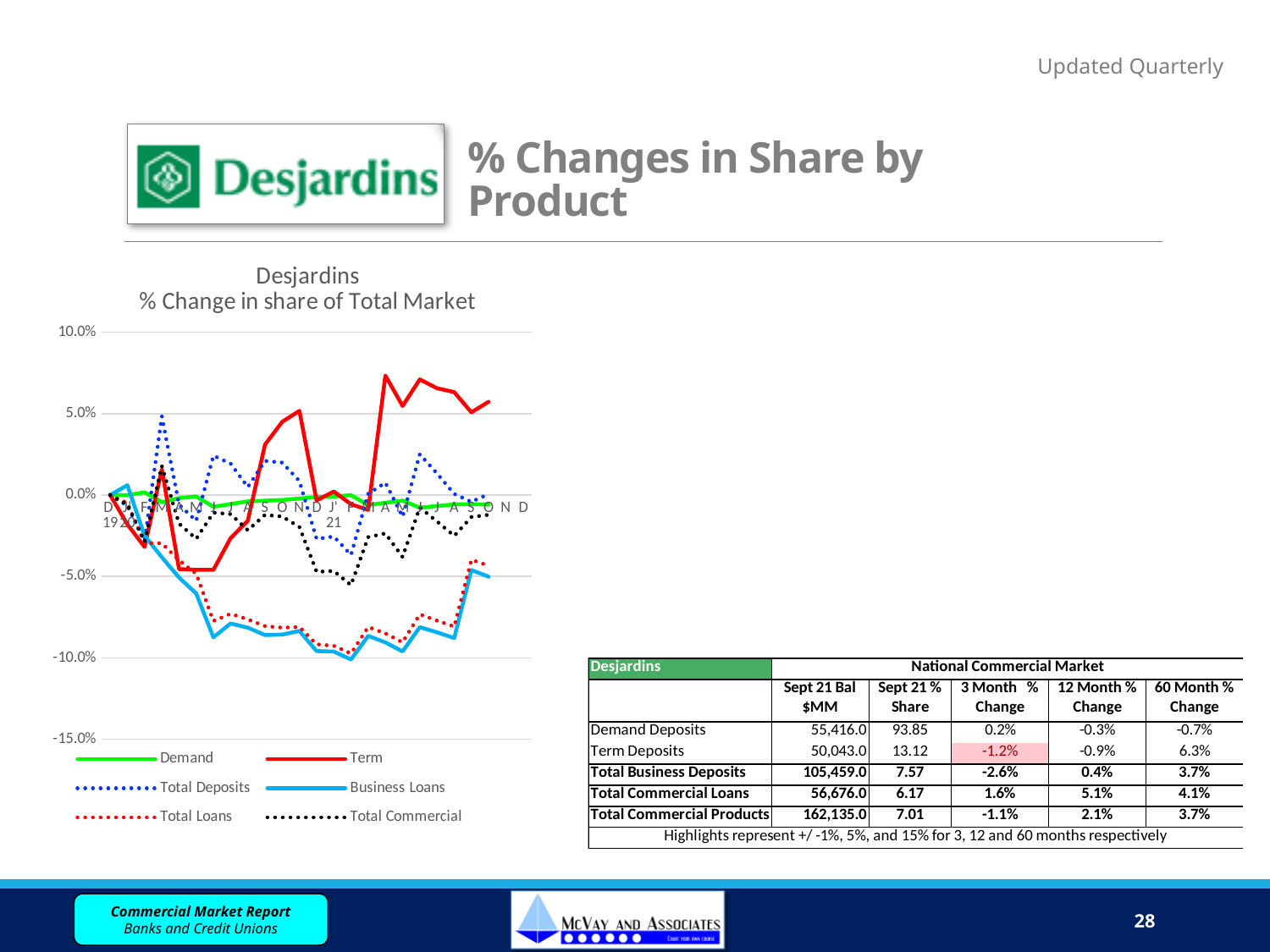
What is the title of the chart? Desjardins % Change in share of Total Market At the end of the chart, which is higher: the Term line or the Business Loans line? Term How many series does the chart legend list? 6 Which series is drawn as a solid green line? Demand Is the peak value of the Term line greater or less than 5.0%? greater Is the lowest value of the Demand line greater or less than -5.0%? greater What is the highest value shown on the vertical axis? 10.0% What kind of chart is shown on the slide? Line chart Is the lowest value of the Business Loans line greater or less than -5.0%? less Which series reaches the lowest value on the chart? Business Loans Which series reaches the highest value on the chart? Term Does the Business Loans line rise or fall from the start of the chart through mid-2020? fall